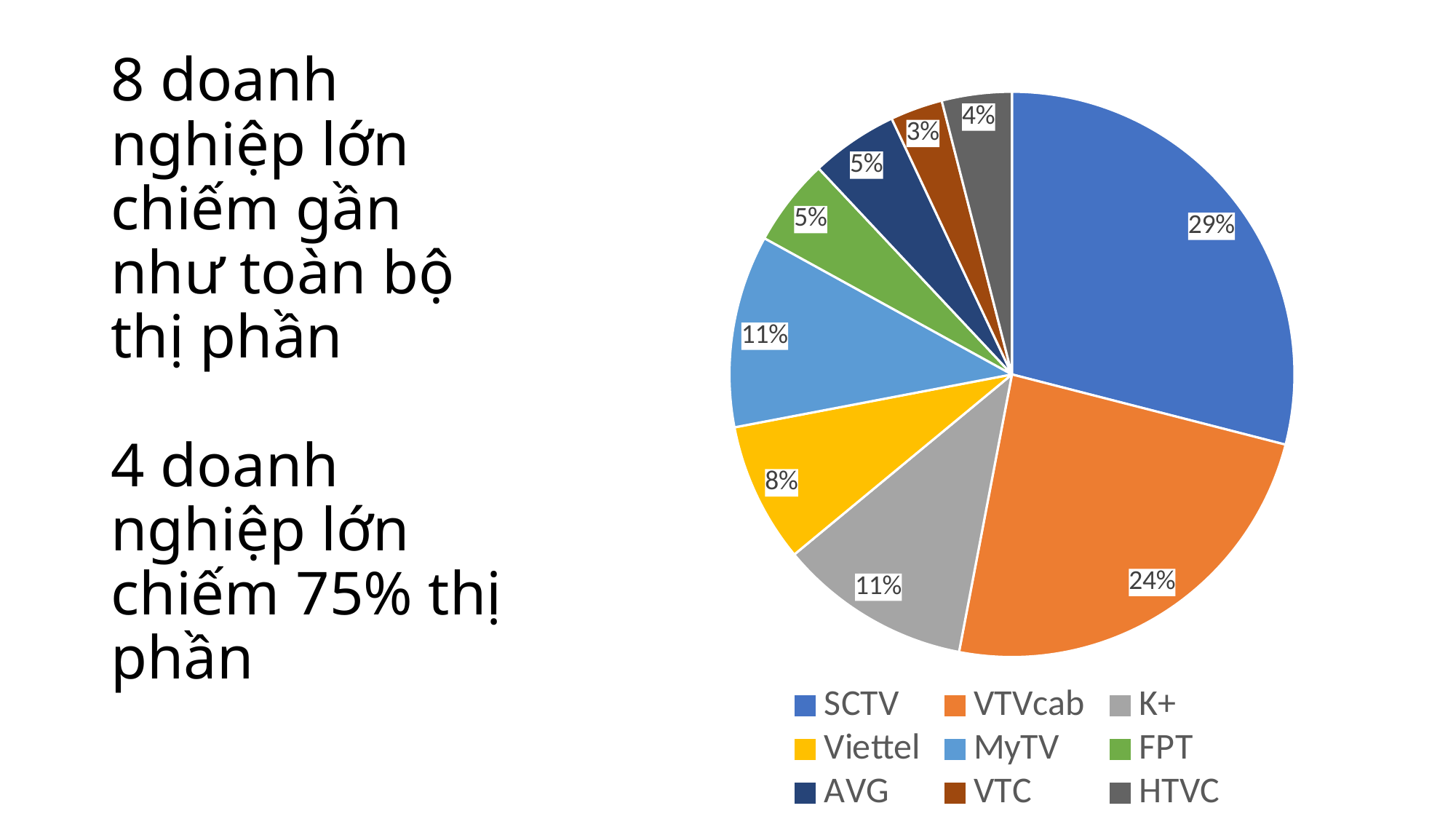
Which category has the largest slice of the pie? SCTV What kind of chart is shown on the slide? pie chart What share of the pie does VTC hold? 3% Which category has the smallest slice of the pie? VTC What share of the pie does SCTV hold? 29% What share of the pie does HTVC hold? 4% What share of the pie does Viettel hold? 8% How many categories does the legend list? 9 What share of the pie does VTVcab hold? 24% Which is larger, the share of Viettel or the share of MyTV? MyTV What colour is the slice for VTVcab? orange What is the difference between the shares of SCTV and VTVcab? 5%